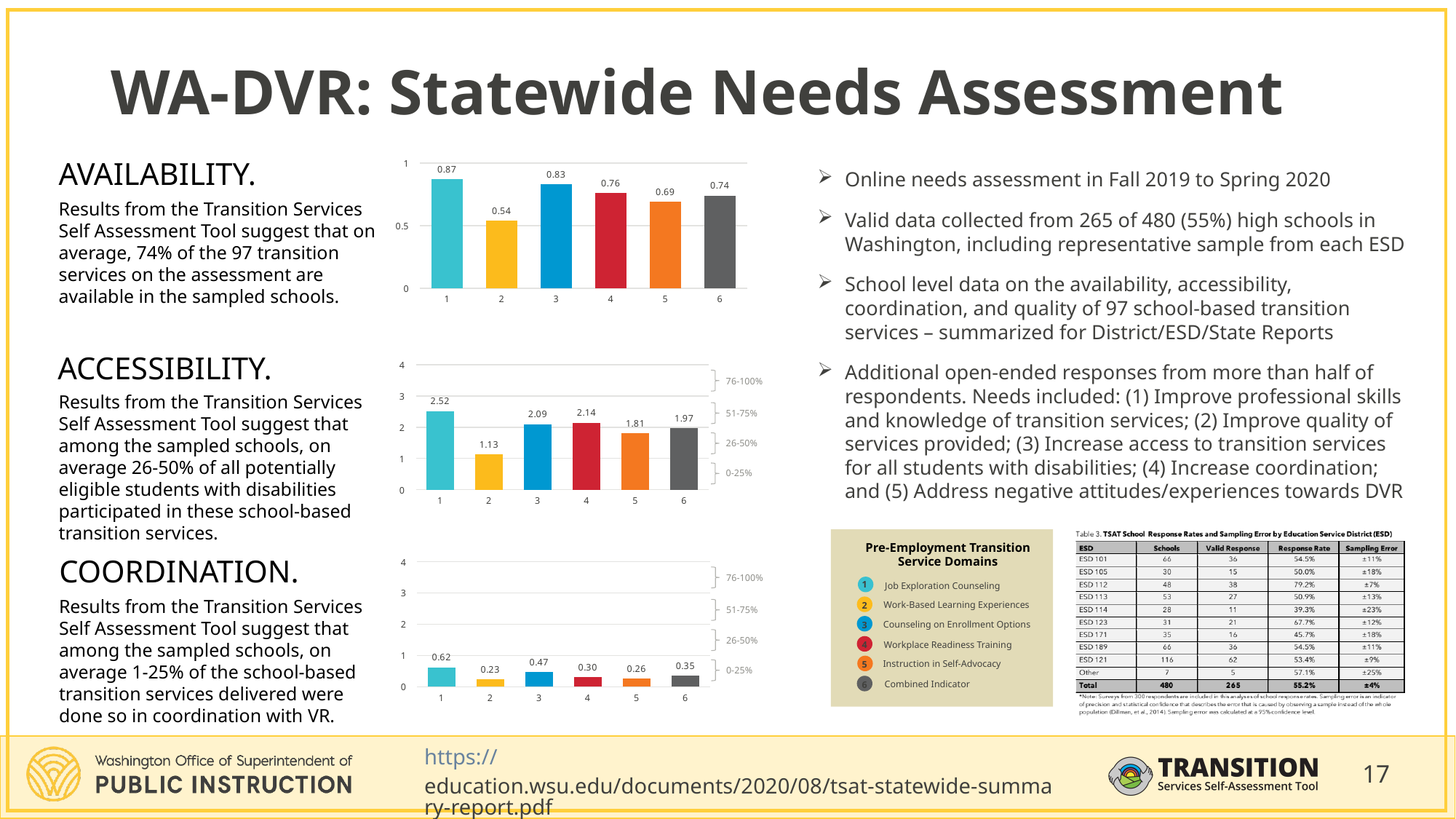
In the top chart (next to AVAILABILITY), what is the difference between the values for category 1 and category 2? 0.33 In the middle chart (next to ACCESSIBILITY), how many bars are plotted? 6 In the middle chart (next to ACCESSIBILITY), which category has the highest value? 1 What type of chart is the top chart (next to AVAILABILITY)? bar chart In the bottom chart (next to COORDINATION), what is the difference between the values for category 1 and category 6? 0.27 In the middle chart (next to ACCESSIBILITY), what is the value for category 4? 2.14 In the top chart (next to AVAILABILITY), what is the value for category 1? 0.87 In the bottom chart (next to COORDINATION), what is the value for category 3? 0.47 In the top chart (next to AVAILABILITY), which category has the lowest value? 2 In the middle chart (next to ACCESSIBILITY), is the value for category 5 larger or smaller than the value for category 6? smaller In the bottom chart (next to COORDINATION), is the value for category 2 greater or less than 1? less In the bottom chart (next to COORDINATION), which category has the highest value? 1